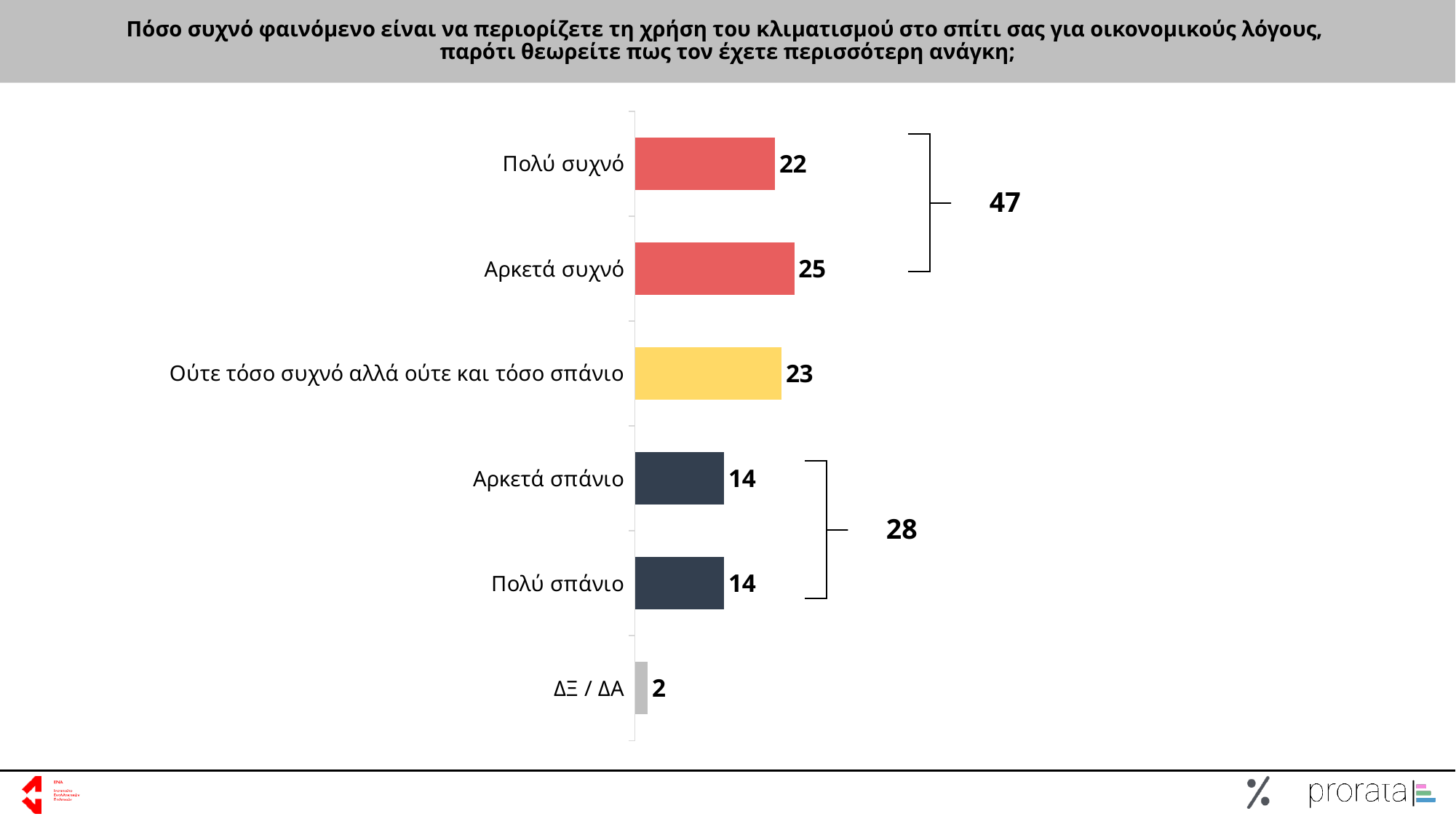
What is the difference between the values for Αρκετά συχνό and Πολύ σπάνιο? 11 What kind of chart is shown on the slide? bar chart Which category has the highest value? Αρκετά συχνό What is the value for Ούτε τόσο συχνό αλλά ούτε και τόσο σπάνιο? 23 What is the value for Αρκετά συχνό? 25 What colour are the bars for Αρκετά σπάνιο and Πολύ σπάνιο? dark blue-grey How many categories are shown in the chart? 6 What is the combined value shown by the bracket for Πολύ συχνό and Αρκετά συχνό? 47 Which is larger, the value for Πολύ συχνό or the value for Αρκετά σπάνιο? Πολύ συχνό What is the combined value shown by the bracket for Αρκετά σπάνιο and Πολύ σπάνιο? 28 What is the value for ΔΞ / ΔΑ? 2 Which category has the lowest value? ΔΞ / ΔΑ